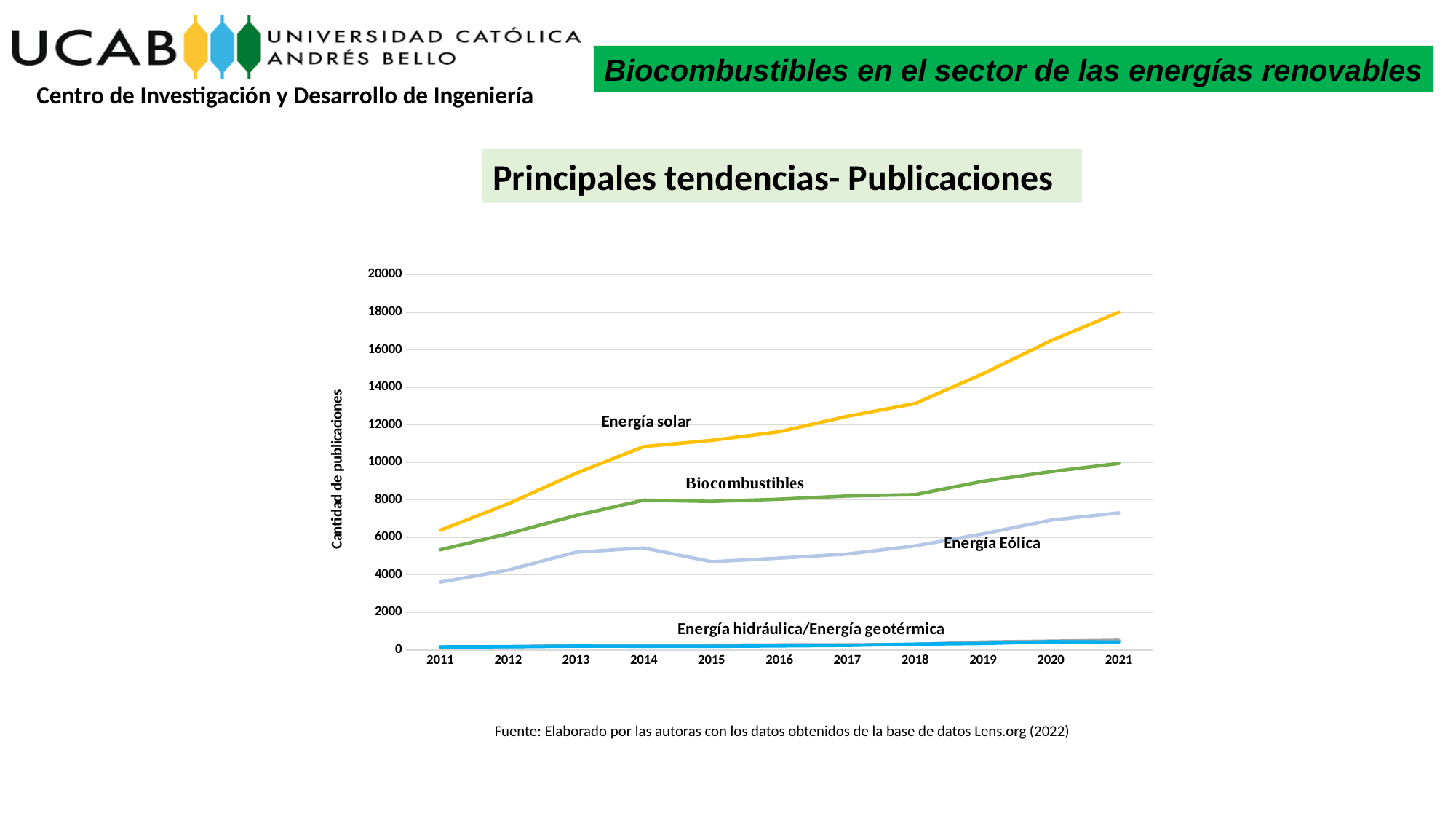
Is the value for Biocombustibles in 2011 greater or less than 6000? less Is the value for Energía solar in 2021 greater or less than 16000? greater What kind of chart is shown on the slide? line chart Is the value for Energía Eólica in 2021 greater or less than 6000? greater Does the Energía solar line rise or fall from 2011 to 2021? rise How many years are shown on the x axis of the chart? 11 What is the label of the y axis of the chart? Cantidad de publicaciones In 2021, which is larger: Energía solar or Biocombustibles? Energía solar Which series has the lowest number of publications across the chart? Energía hidráulica/Energía geotérmica Which series has the highest number of publications in 2021? Energía solar